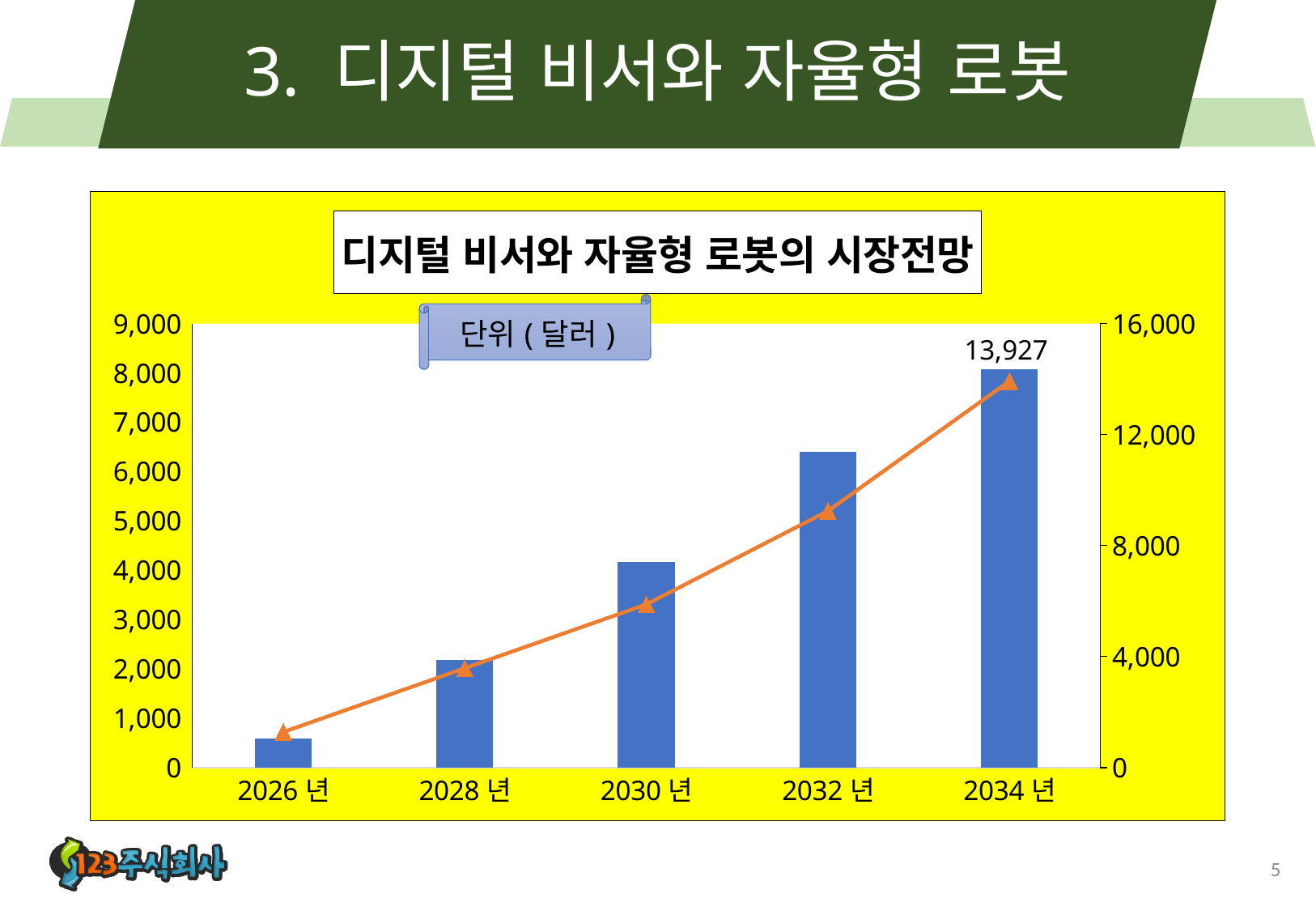
Which year has the tallest bar? 2034 년 Is the bar value for 2026 년 on the left axis greater or less than 1,000? less What is the data label shown on the line at 2034 년? 13,927 Do the bar values rise or fall from 2026 년 to 2034 년? rise Is the bar value for 2030 년 on the left axis greater or less than 5,000? less How many years are shown on the x axis? 5 What is the title of the chart? 디지털 비서와 자율형 로봇의 시장전망 Which bar is taller, 2030 년 or 2032 년? 2032 년 Which year has the shortest bar? 2026 년 What kind of chart is this? combined bar and line chart Is the bar value for 2034 년 on the left axis greater or less than 7,000? greater